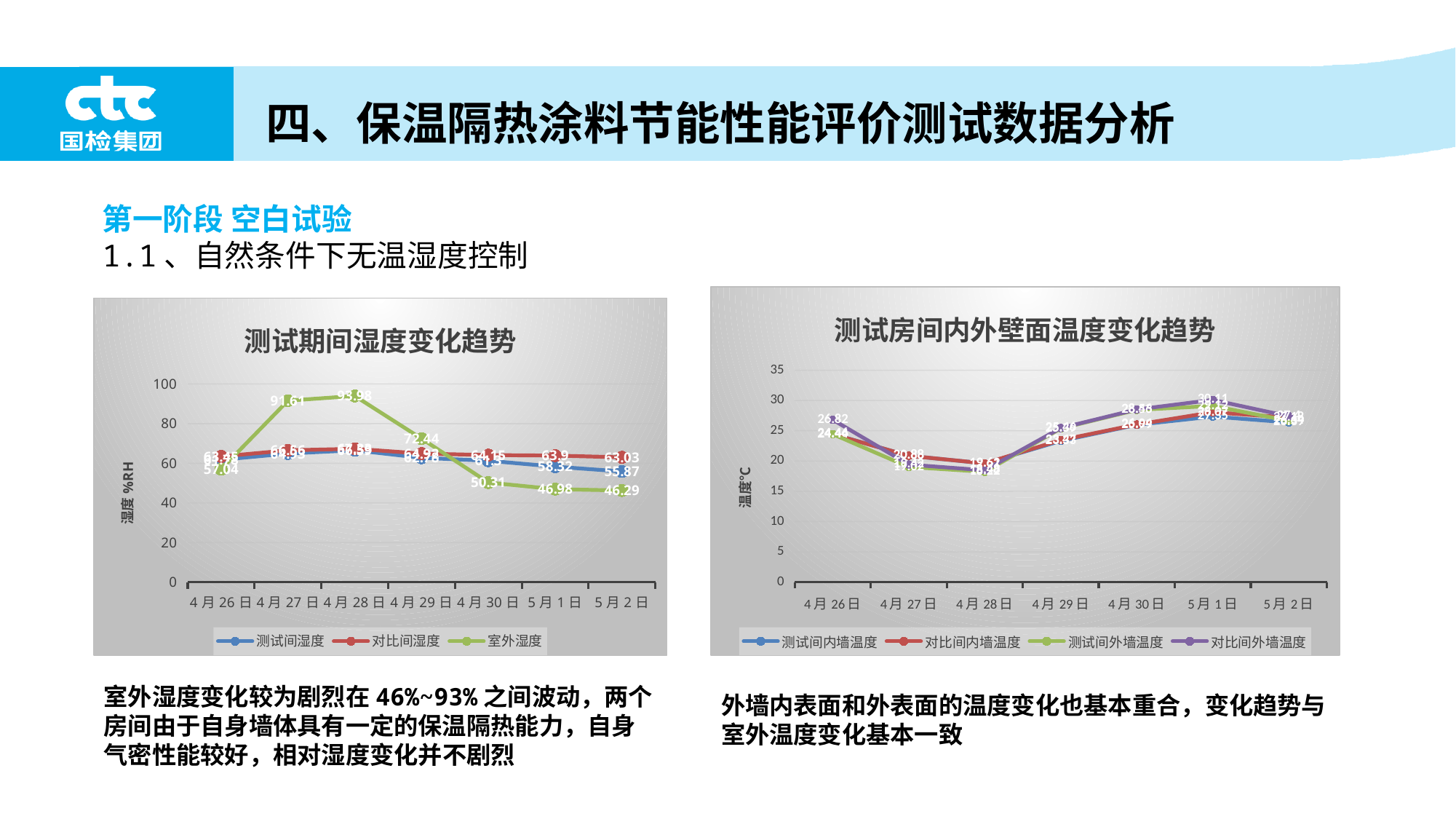
In the left chart (测试期间湿度变化趋势), what is the value of 测试间湿度 on 5月2日? 55.87 In the left chart (测试期间湿度变化趋势), on which date is 室外湿度 lowest? 5月2日 In the left chart (测试期间湿度变化趋势), on which date is 室外湿度 highest? 4月28日 In the left chart (测试期间湿度变化趋势), which is larger on 5月2日: 对比间湿度 or 测试间湿度? 对比间湿度 How many dates are plotted along the x axis of the left chart (测试期间湿度变化趋势)? 7 In the left chart (测试期间湿度变化趋势), what is the difference between the 室外湿度 values on 4月28日 and 5月2日? 47.69 In the right chart (测试房间内外壁面温度变化趋势), is the value for 测试间外墙温度 on 4月28日 greater or less than 25? less How many series does the legend of the left chart (测试期间湿度变化趋势) list? 3 In the left chart (测试期间湿度变化趋势), does 室外湿度 rise or fall from 4月28日 to 5月2日? fall How many series does the legend of the right chart (测试房间内外壁面温度变化趋势) list? 4 In the left chart (测试期间湿度变化趋势), what is the value of 室外湿度 on 4月28日? 93.98 What kind of chart is the left chart titled 测试期间湿度变化趋势? line chart